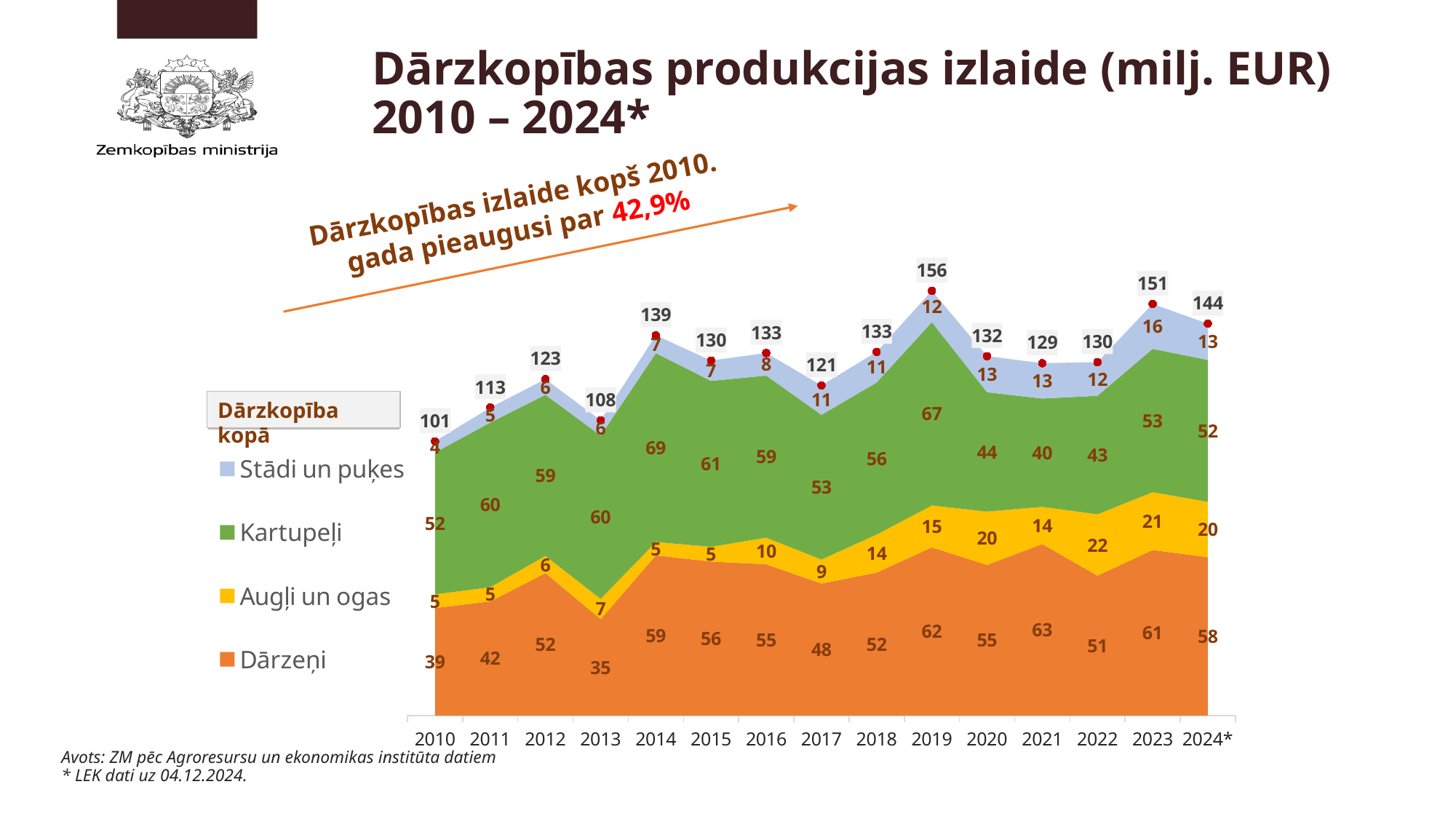
By what percentage has horticultural output grown since 2010, according to the annotation on the slide? 42,9% What is the value for Augļi un ogas in 2022? 22 What kind of chart is this? Stacked area chart What was the total horticultural output (Dārzkopība kopā) in 2019? 156 What is the value for Kartupeļi in 2014? 69 What is the value for Stādi un puķes in 2023? 16 By how much did the total horticultural output change from 2010 to 2019? 55 What is the value for Dārzeņi in 2021? 63 In which year was the total horticultural output highest? 2019 In which year was the total horticultural output lowest? 2010 How many years are shown on the x axis? 15 Which was larger in 2020: Dārzeņi or Kartupeļi? Dārzeņi